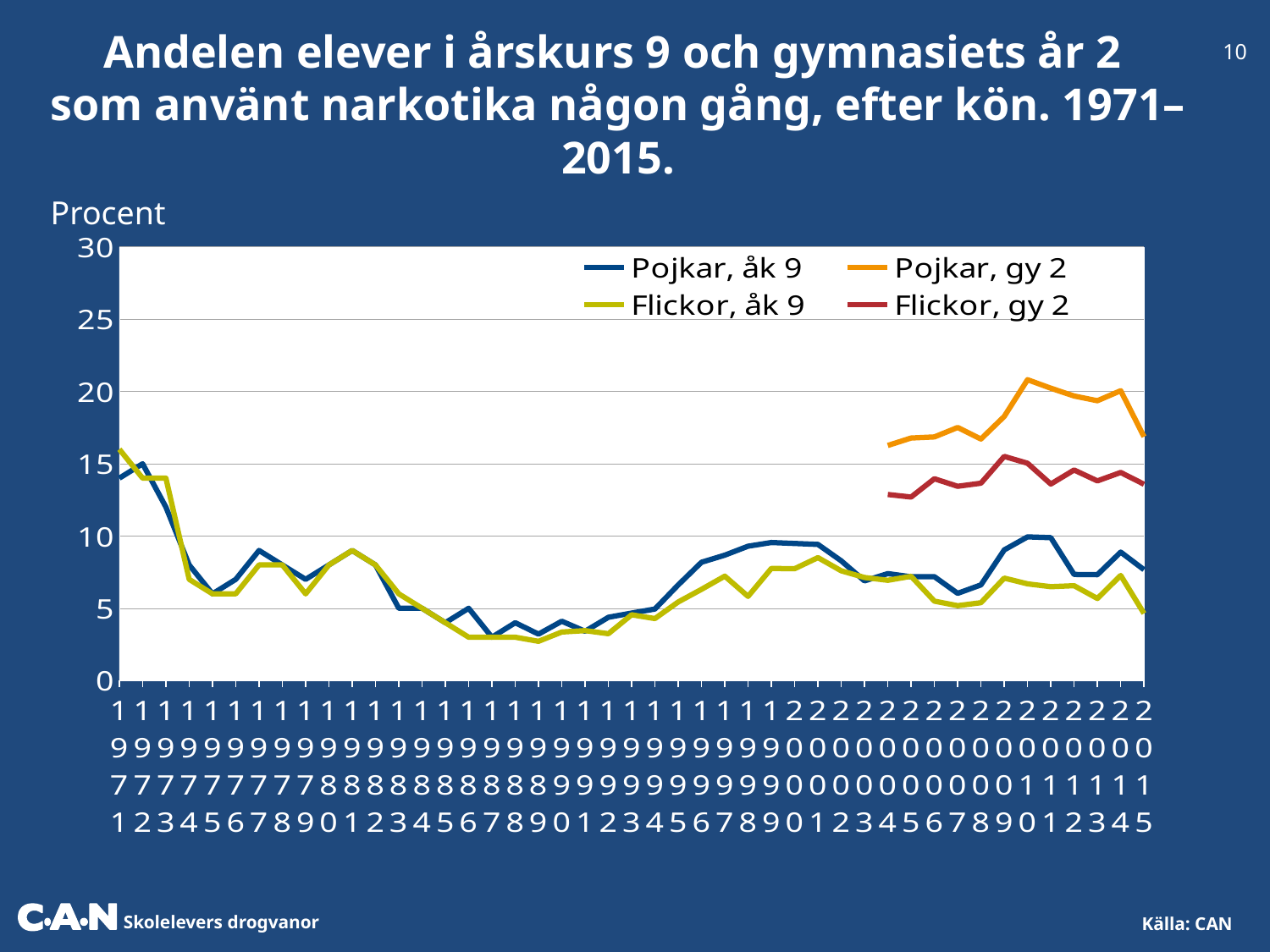
Is the value for Pojkar, gy 2 in 2010 greater or less than 20? greater How many series does the legend list? 4 What type of chart is shown on the slide? line chart Which series has the lowest value in 2015? Flickor, åk 9 Is the value for Pojkar, åk 9 in 2015 greater or less than 10? less Which series has the highest value in 2010? Pojkar, gy 2 Does the Pojkar, gy 2 line rise or fall between 2004 and 2010? rise How many years are plotted along the x axis (1971 to 2015)? 45 What are the four series named in the legend? Pojkar, åk 9; Pojkar, gy 2; Flickor, åk 9; Flickor, gy 2 In 2015, which is larger: Pojkar, gy 2 or Flickor, gy 2? Pojkar, gy 2 Is the value for Flickor, åk 9 in 1988 greater or less than 5? less What unit is shown on the y axis label? Procent